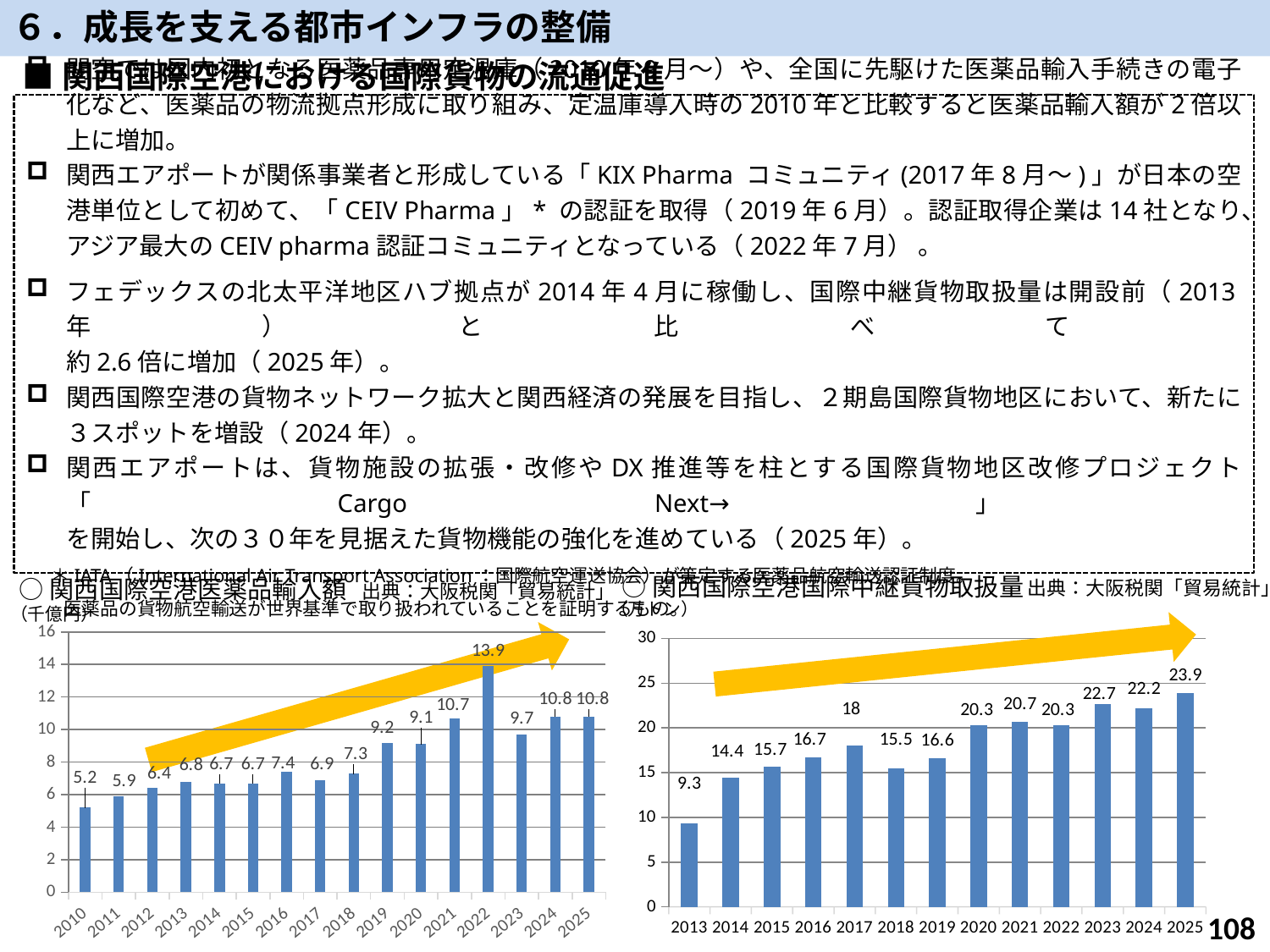
In the right chart (関西国際空港国際中継貨物取扱量), what is the value for 2025? 23.9 In the left chart (関西国際空港医薬品輸入額), which year has the highest value? 2022 In the right chart (関西国際空港国際中継貨物取扱量), which year has the lowest value? 2013 In the left chart (関西国際空港医薬品輸入額), what is the difference between the 2022 value and the 2010 value? 8.7 In the right chart (関西国際空港国際中継貨物取扱量), which year has the larger value, 2017 or 2018? 2017 In the right chart (関西国際空港国際中継貨物取扱量), do the values generally rise or fall from 2013 to 2025? rise In the left chart (関西国際空港医薬品輸入額), what is the value for 2022? 13.9 What kind of chart is the right chart (関西国際空港国際中継貨物取扱量)? bar chart In the right chart (関西国際空港国際中継貨物取扱量), what is the difference between the 2025 value and the 2013 value? 14.6 How many years are plotted in the left chart (関西国際空港医薬品輸入額)? 16 How many years are plotted in the right chart (関西国際空港国際中継貨物取扱量)? 13 In the left chart (関西国際空港医薬品輸入額), which year has the lowest value? 2010